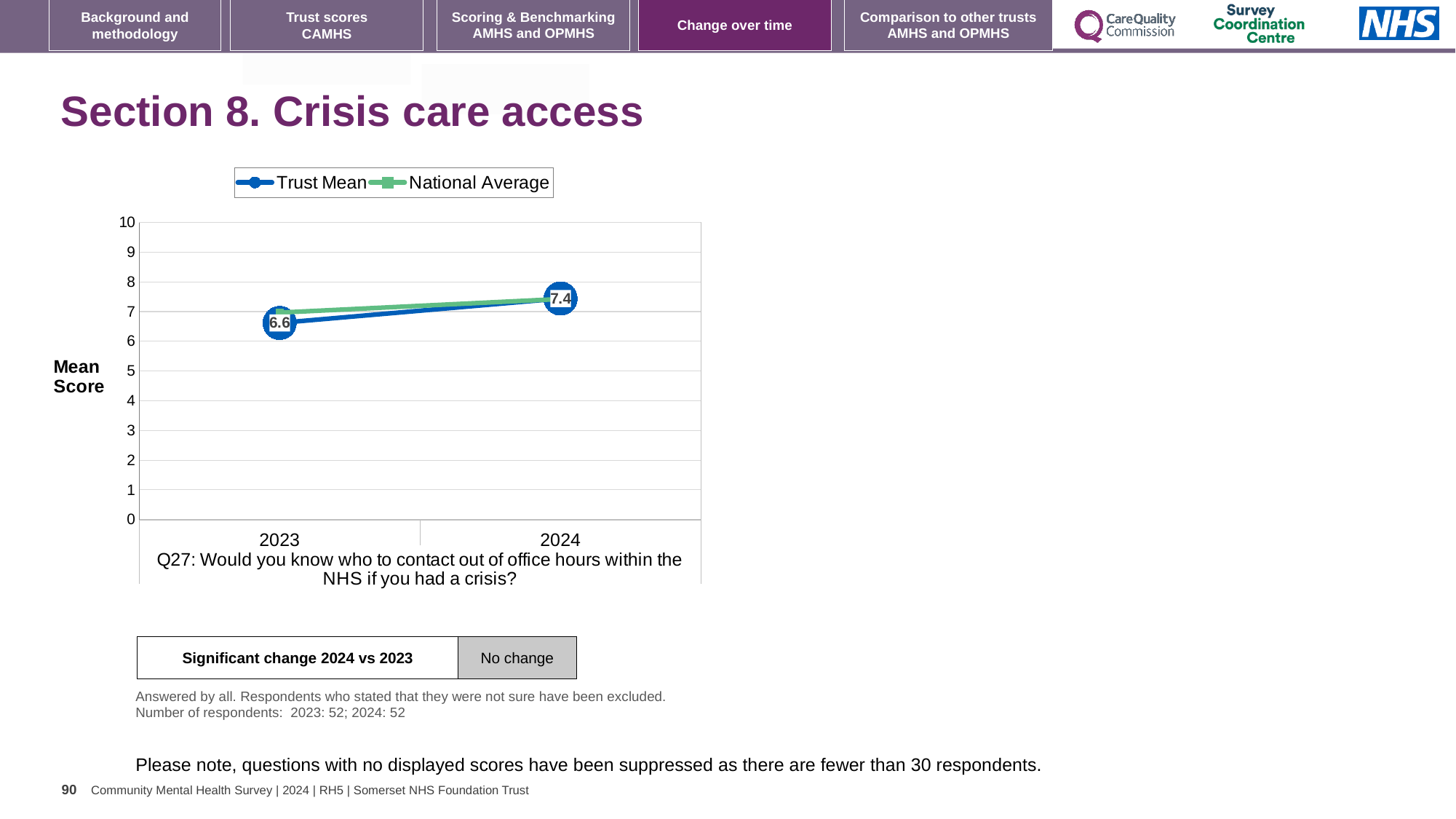
Is the National Average value for 2023 greater or less than 5? greater Which year has the higher Trust Mean score, 2023 or 2024? 2024 What is the Trust Mean score for 2024? 7.4 Does the Trust Mean score rise or fall from 2023 to 2024? rise In which year is the Trust Mean score highest? 2024 How many years are plotted on the x axis of the chart? 2 What kind of chart is shown on the slide? line chart What is the label on the y axis of the chart? Mean Score What is the Trust Mean score for 2023? 6.6 How many series does the chart legend list? 2 In which year is the Trust Mean score lowest? 2023 By how much did the Trust Mean score change from 2023 to 2024? 0.8